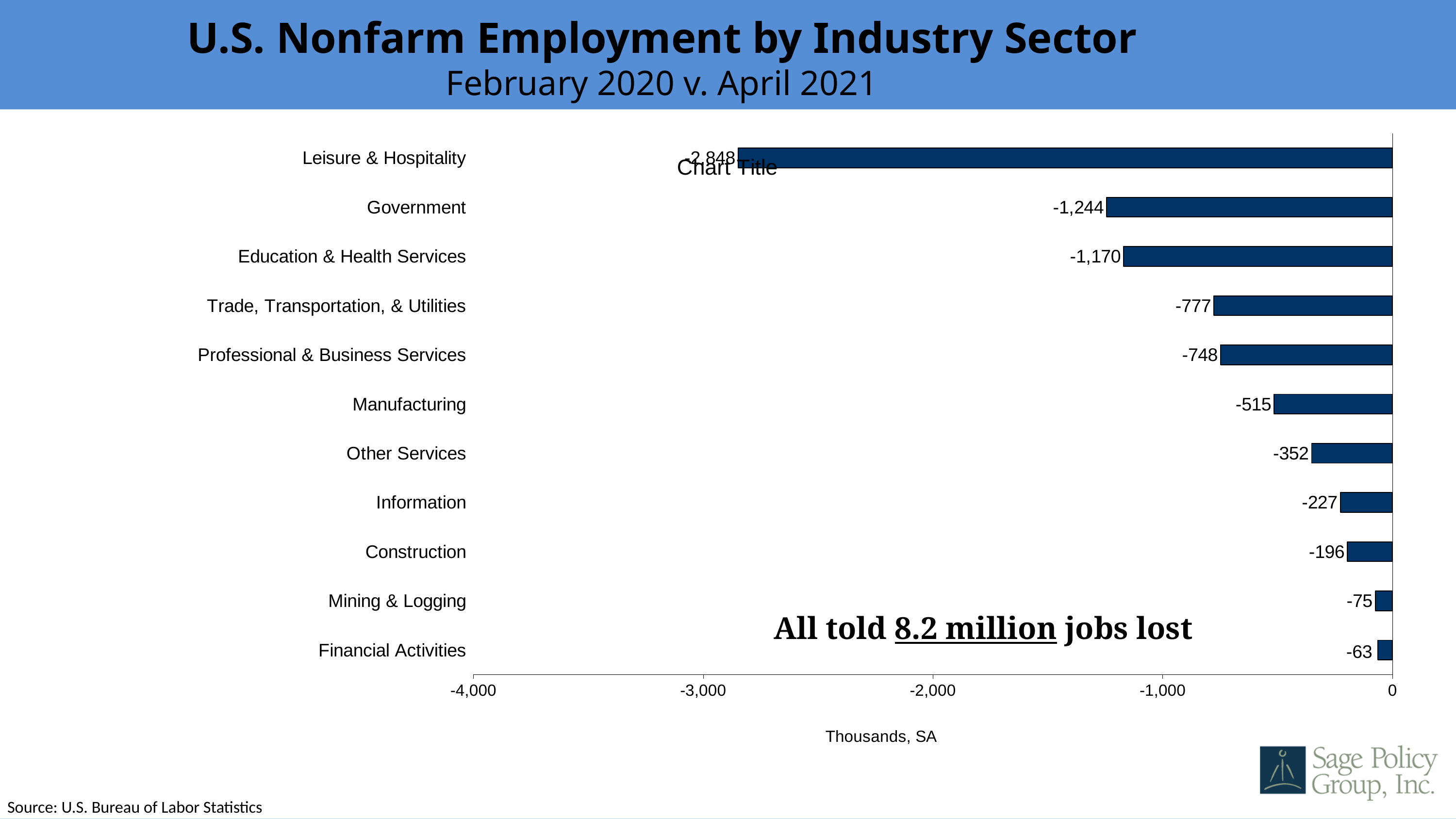
How many industry sectors are shown in the chart? 11 What is the label on the horizontal axis of the chart? Thousands, SA What is the value for Manufacturing? -515 Is the value for Leisure & Hospitality greater or less than -2,000? less What is the value for Financial Activities? -63 What is the difference between the values for Government and Education & Health Services? 74 Which industry sector has the highest (least negative) value? Financial Activities What is the value for Trade, Transportation, & Utilities? -777 Which industry sector has the lowest (most negative) value? Leisure & Hospitality What kind of chart is shown on the slide? bar chart Which has the larger job loss, Other Services or Information? Other Services What is the value for Government? -1,244